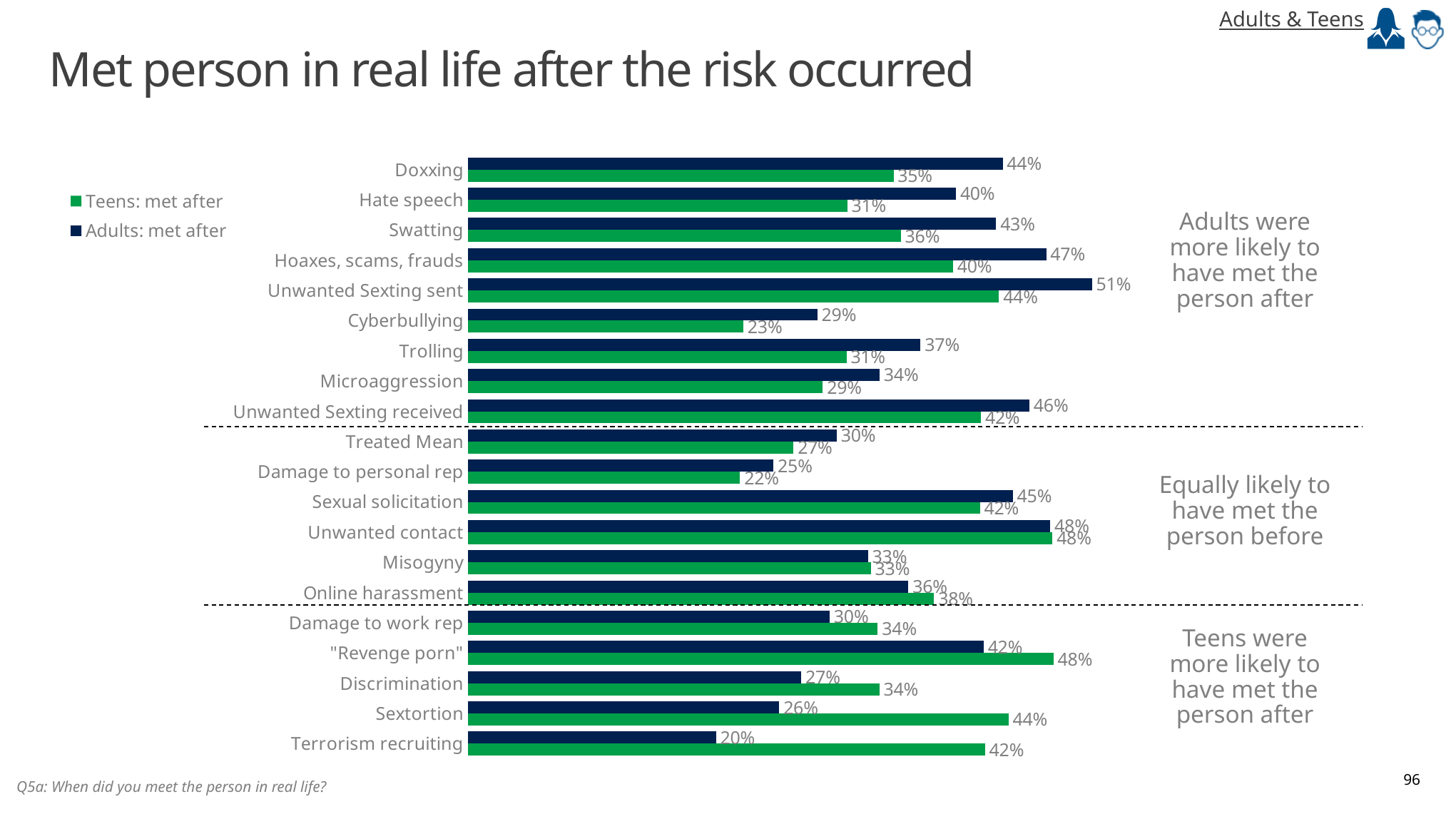
For Cyberbullying, which is larger: the Adults value or the Teens value? Adults What is the value for Teens: met after for Sextortion? 44% What type of chart is shown on the slide? Bar chart Which category has the highest value for Adults: met after? Unwanted Sexting sent Which category has the lowest value for Adults: met after? Terrorism recruiting How many risk categories are shown on the chart? 20 What percentage of adults met the person after the risk occurred for Doxxing? 44% Which category has the lowest value for Teens: met after? Damage to personal rep What is the value for Adults: met after for Terrorism recruiting? 20% What is the difference between the Adults and Teens values for Terrorism recruiting? 22% How many series does the legend list? 2 For "Revenge porn", which is larger: the Teens value or the Adults value? Teens